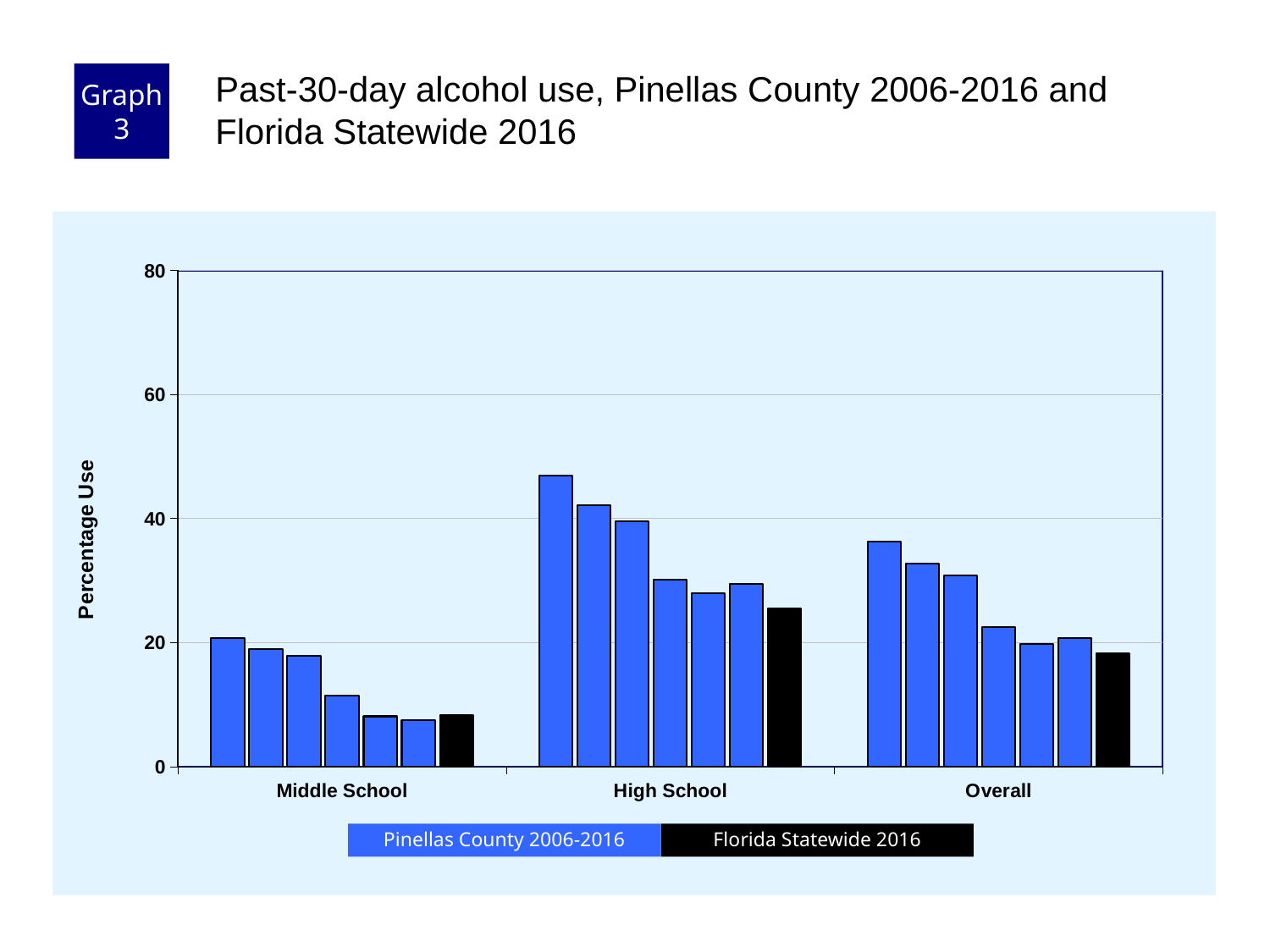
How many school-level categories are shown on the x axis? 3 What is the label on the y axis? Percentage Use Is the value of the tallest Pinellas County bar for High School greater or less than 40? greater Within the High School group, do the Pinellas County bars generally rise or fall from left to right? fall What kind of chart is shown on the slide? bar chart Which category has the shortest bars overall? Middle School Is the Florida Statewide 2016 value for High School greater or less than 40? less Is the Florida Statewide 2016 value for Middle School greater or less than 20? less Which is larger, the Florida Statewide 2016 value for High School or for Middle School? High School Which category has the tallest bars overall? High School How many series does the legend list? 2 Which colour represents Florida Statewide 2016 in the chart? black